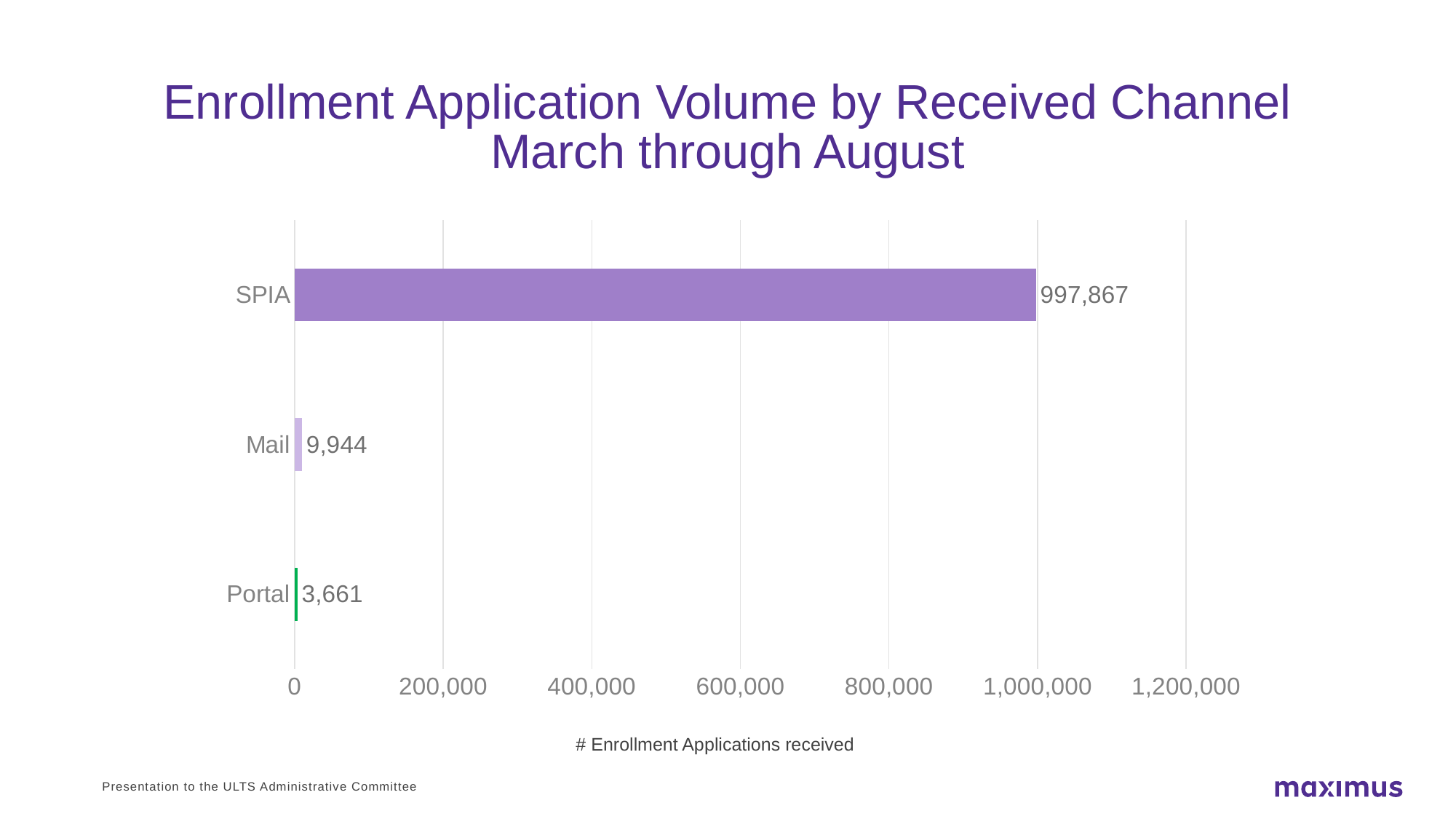
What is the difference between the values for SPIA and Mail? 987,923 What is the difference between the values for Mail and Portal? 6,283 Which channel has the lowest number of enrollment applications received? Portal What is the value for Portal? 3,661 Which channel has the highest number of enrollment applications received? SPIA Is the value for SPIA greater or less than 800,000? greater What is the label of the horizontal axis? # Enrollment Applications received What is the value for SPIA? 997,867 Which is larger, the value for Mail or the value for Portal? Mail What is the value for Mail? 9,944 What kind of chart is shown on the slide? Bar chart How many channels are shown in the chart? 3